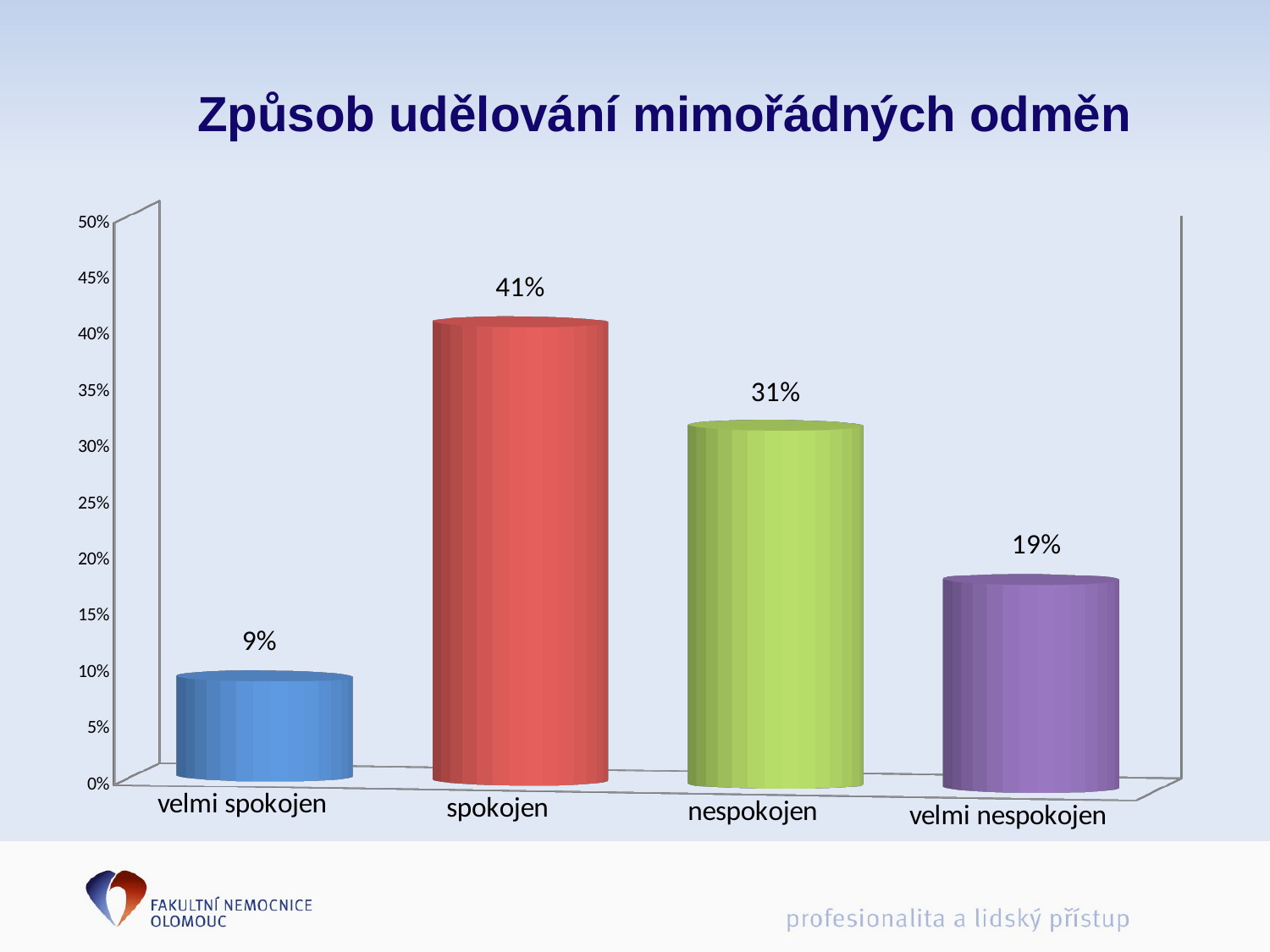
What is the difference between the values for "spokojen" and "nespokojen"? 10% What kind of chart is shown on the slide? bar chart How many categories are shown on the x axis? 4 What is the value for "velmi nespokojen"? 19% What is the difference between the values for "velmi nespokojen" and "velmi spokojen"? 10% Which category has the lowest value? velmi spokojen Which category has the highest value? spokojen Is the value for "nespokojen" greater or less than 25%? greater What is the title of the slide? Způsob udělování mimořádných odměn Which is larger, the value for "nespokojen" or the value for "velmi nespokojen"? nespokojen What is the value for "spokojen"? 41% What is the value for "velmi spokojen"? 9%